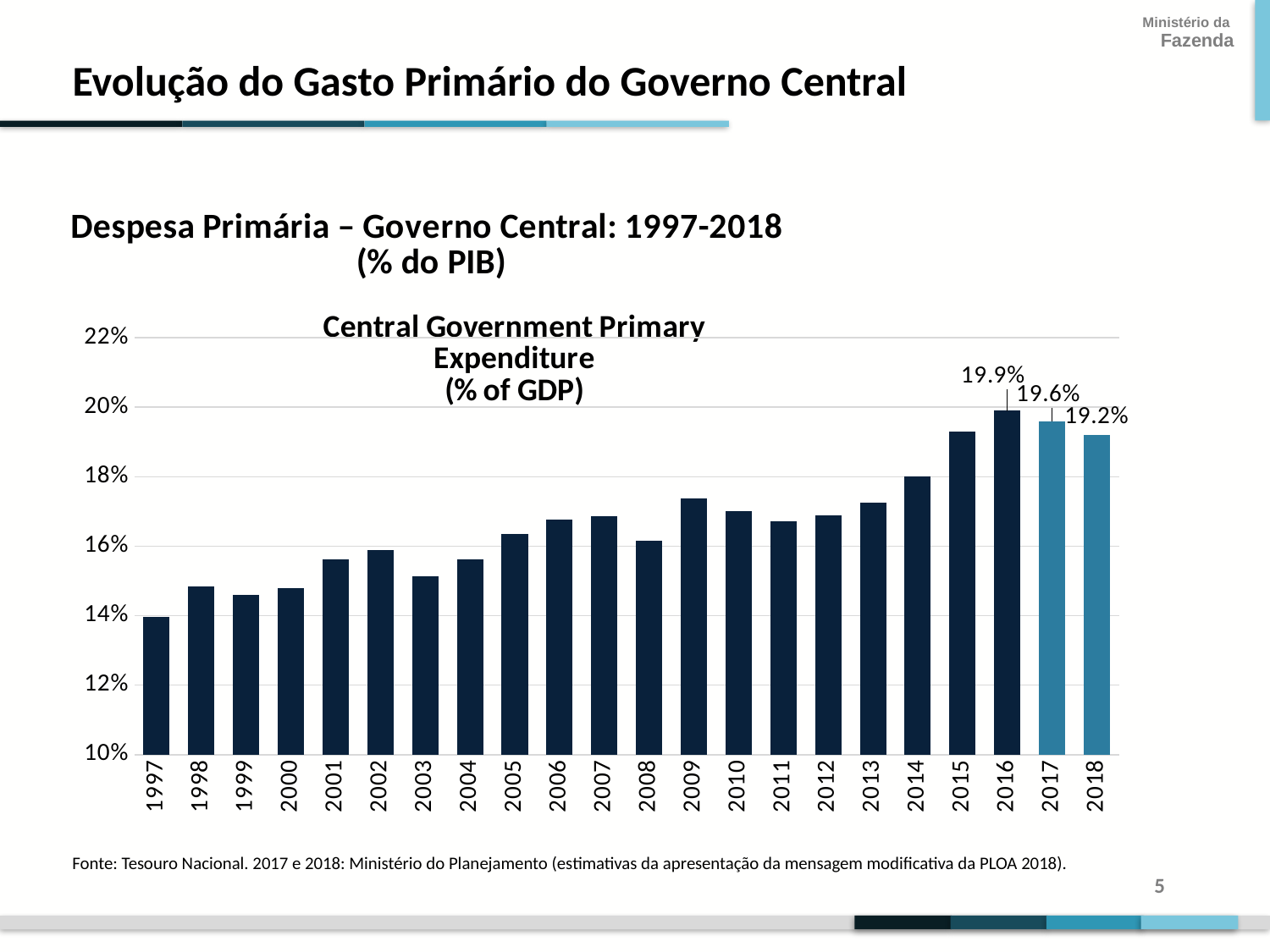
Which year has the highest value? 2016 Is the value for 2003 greater or less than 16%? less What kind of chart is this? bar chart What is the value for 2018? 19.2% Do the values generally rise or fall from 1997 to 2016? rise What is the value for 2016? 19.9% What is the value for 2017? 19.6% What is the difference between the values for 2016 and 2018? 0.7% How many years are shown on the x axis? 22 Which year has the lowest value? 1997 Which is larger, the value for 2017 or the value for 2018? 2017 Is the value for 2015 greater or less than 18%? greater